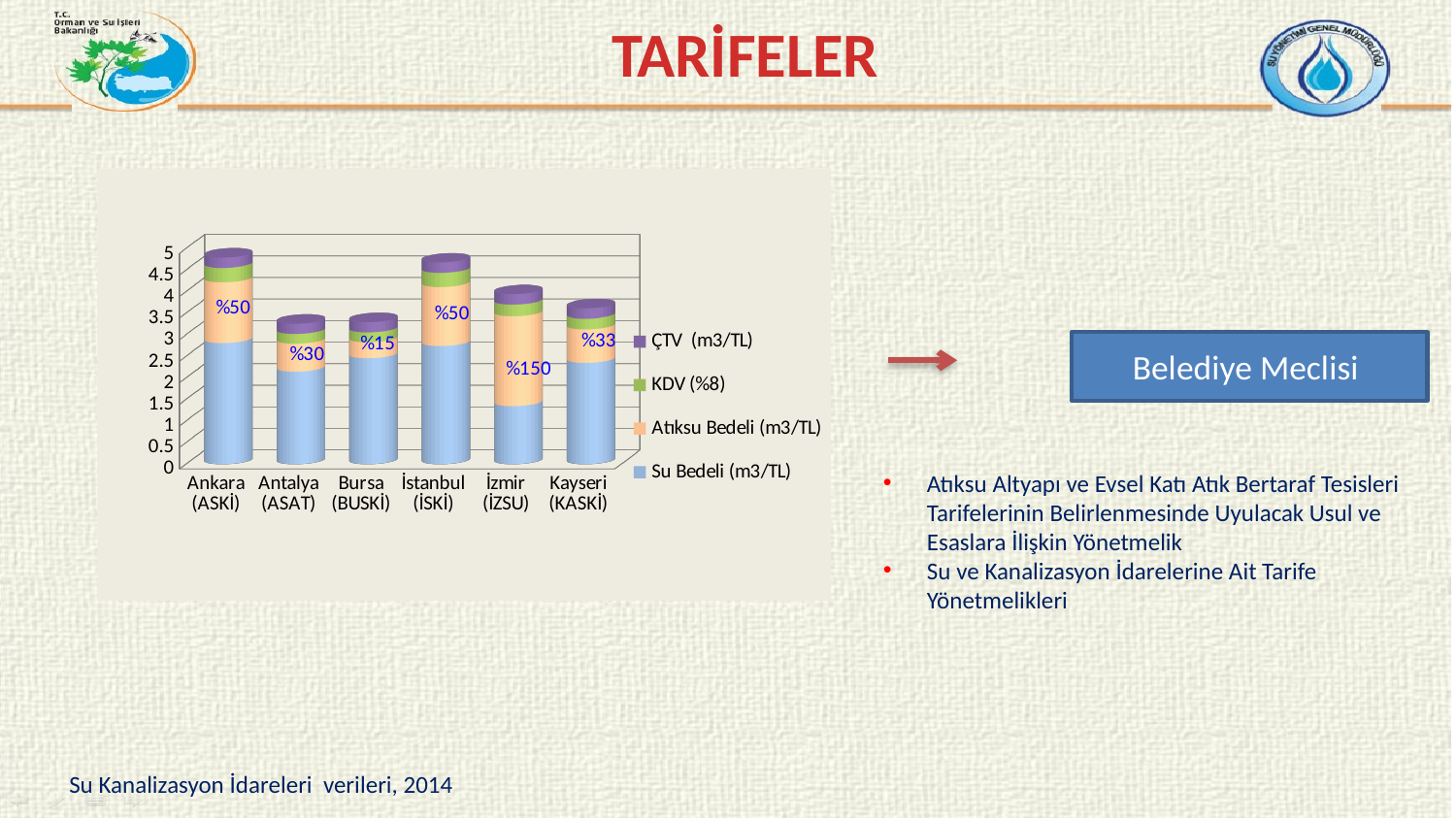
Is the total height of the Antalya (ASAT) bar greater or less than 3.5? less What percentage label is printed on the Bursa (BUSKİ) bar? %15 Is the total height of the Ankara (ASKİ) bar greater or less than 4.5? greater How many series does the chart legend list? 4 Which legend entry is shown in purple? ÇTV (m3/TL) Which bar is taller in total, Ankara (ASKİ) or Antalya (ASAT)? Ankara (ASKİ) Is the Su Bedeli (m3/TL) value for İzmir (İZSU) greater or less than 2? less How many cities (categories) are shown on the x axis of the chart? 6 What kind of chart is shown on the slide? stacked bar chart What percentage label is printed on the Kayseri (KASKİ) bar? %33 What percentage label is printed on the İzmir (İZSU) bar? %150 Which city has the larger Su Bedeli (m3/TL) segment, Ankara (ASKİ) or İzmir (İZSU)? Ankara (ASKİ)